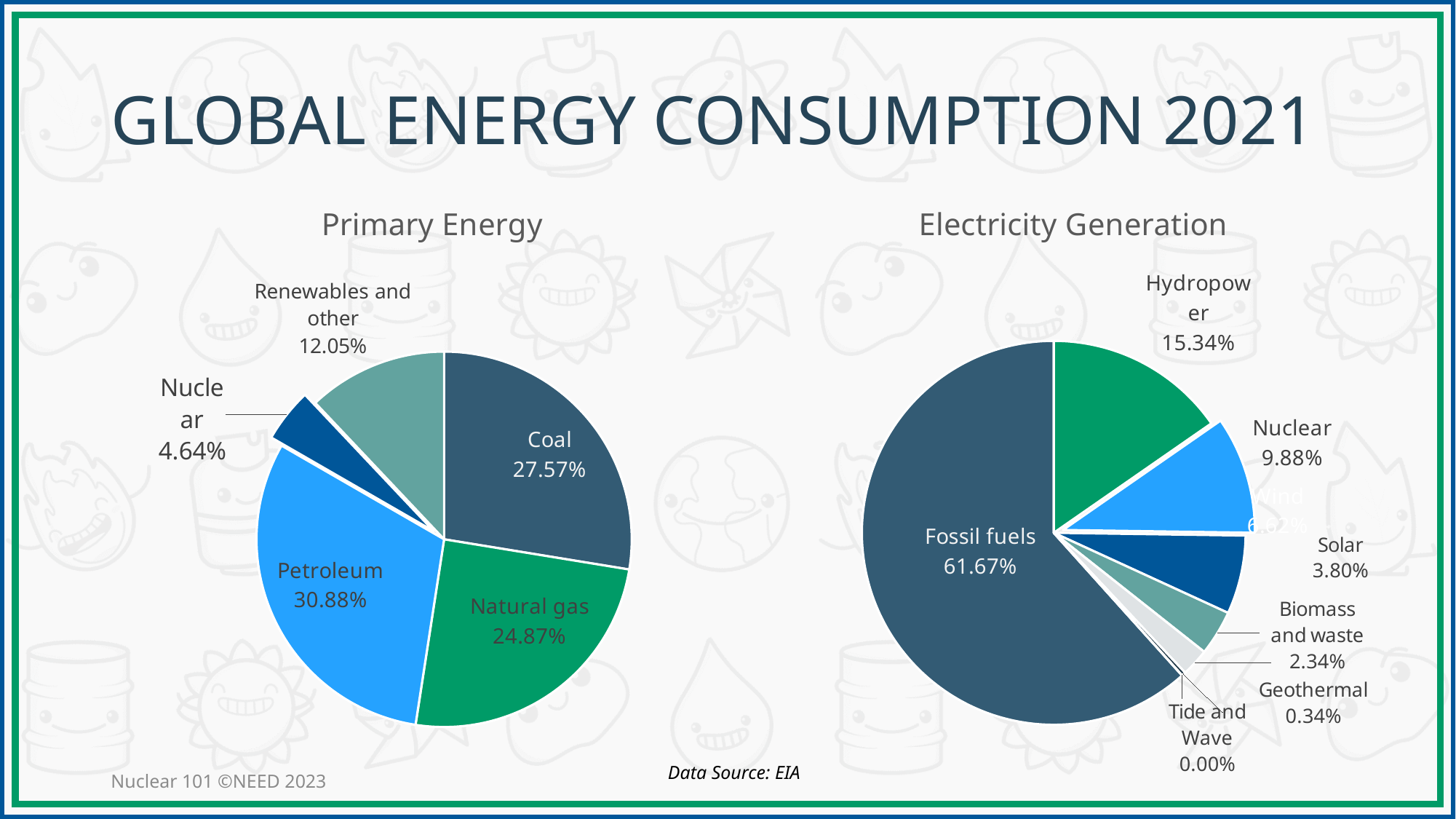
How many slices does the Primary Energy pie chart have? 5 In the Electricity Generation chart, which source has the largest share? Fossil fuels What type of chart is used for Electricity Generation? Pie chart In the Electricity Generation chart, what is the difference between the Hydropower and Nuclear shares? 5.46% In the Primary Energy chart, which source has the largest share? Petroleum In the Primary Energy chart, what share does Petroleum have? 30.88% In the Primary Energy chart, what share does Coal have? 27.57% In the Electricity Generation chart, which is larger, Nuclear or Solar? Nuclear In the Primary Energy chart, what is the difference between the Coal and Natural gas shares? 2.70% In the Electricity Generation chart, what share does Hydropower have? 15.34% In the Primary Energy chart, which source has the smallest share? Nuclear In the Electricity Generation chart, what share do Fossil fuels have? 61.67%